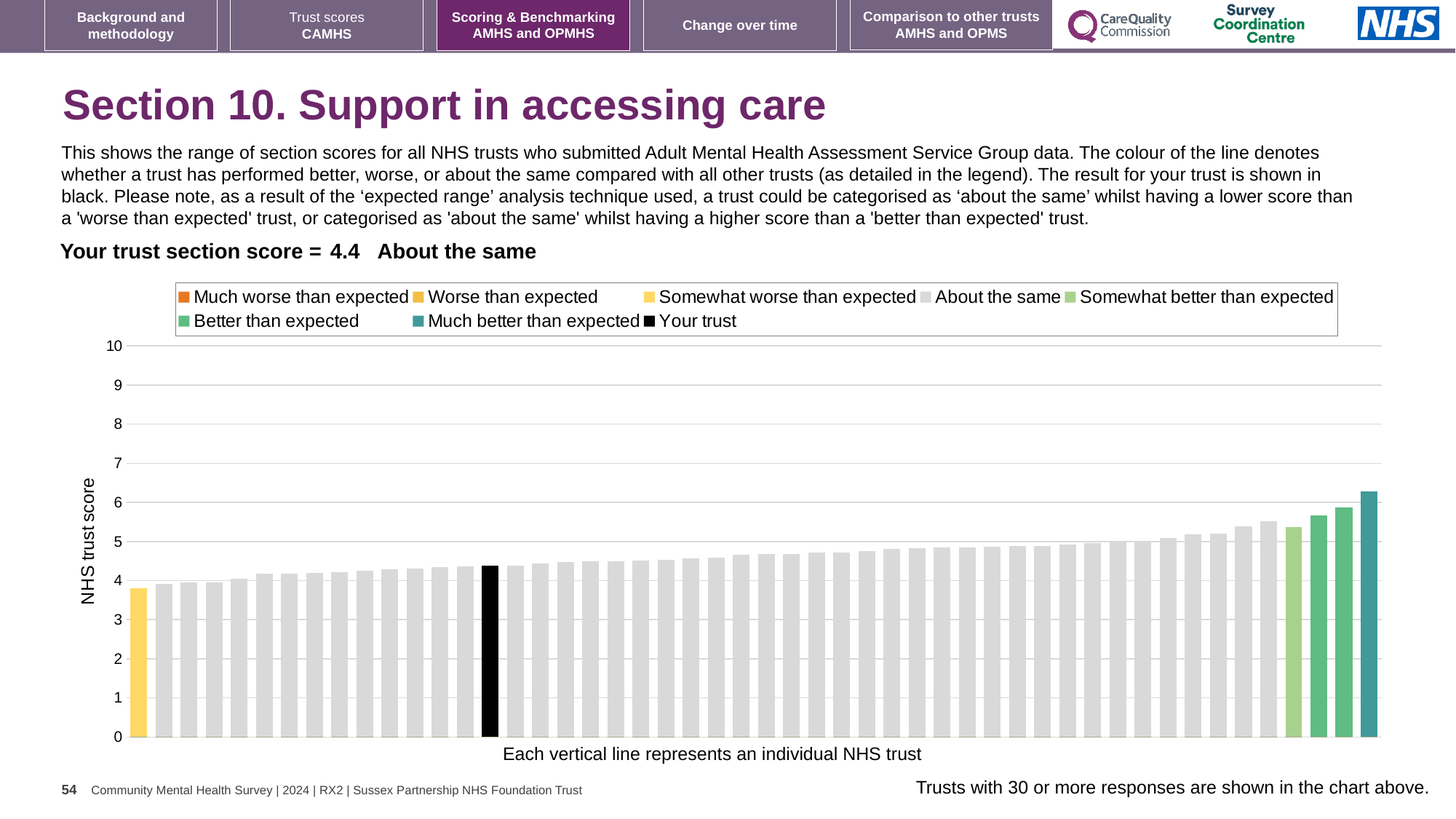
Which category is your trust's section score placed in? About the same What kind of chart is shown on the slide? bar chart How many entries does the chart legend list? 8 What is the title of the vertical axis? NHS trust score Do the bar values rise or fall from left to right along the x axis? rise Which legend category does the tallest bar belong to? Much better than expected Is the value of the tallest bar greater or less than 7? less What is your trust's section score for Section 10, Support in accessing care? 4.4 Is the value of the shortest bar greater or less than 4? less Which legend category does the shortest bar belong to? Somewhat worse than expected Is the value for your trust (the black bar) greater or less than 4? greater